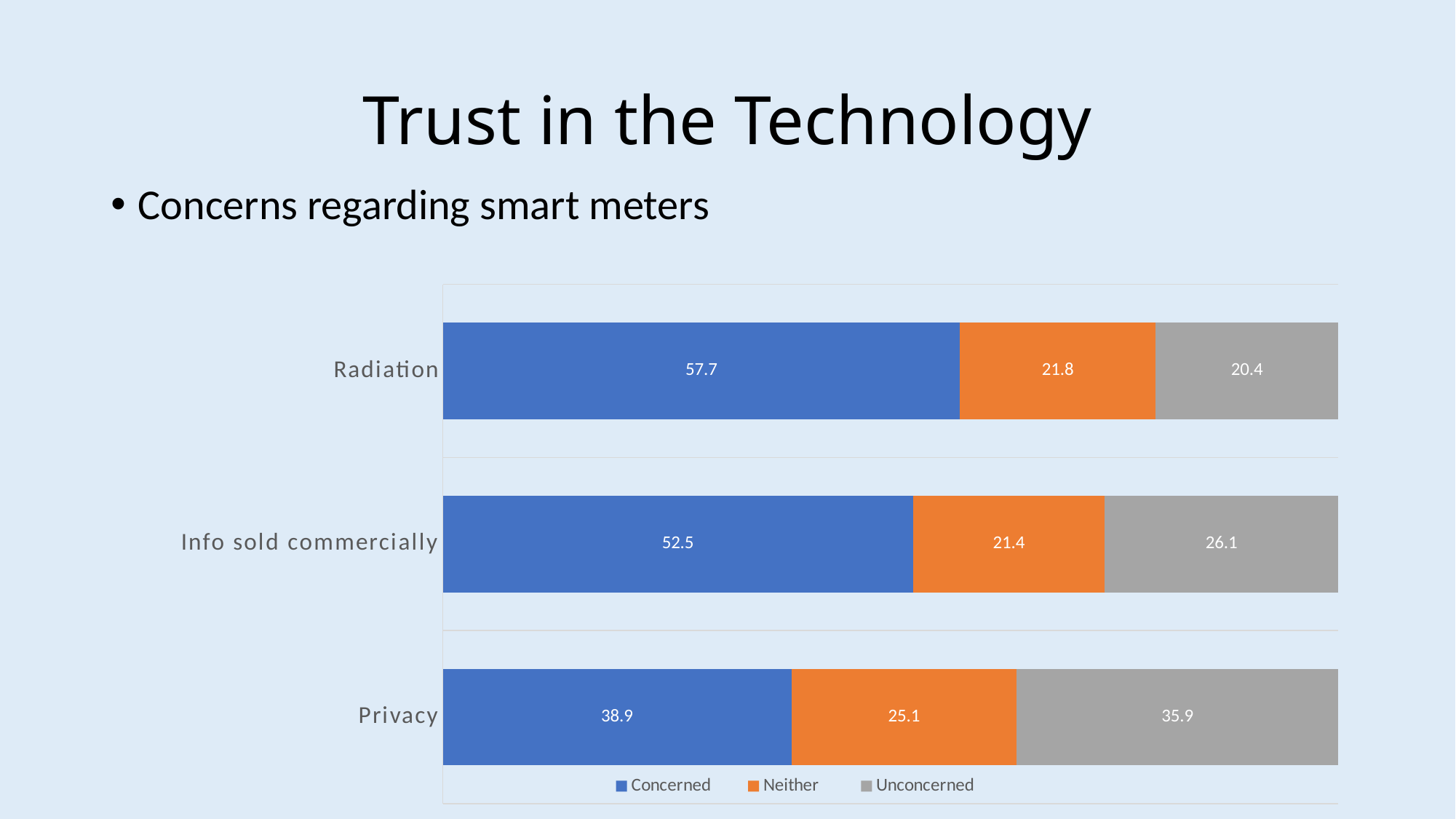
What is the Neither value for Info sold commercially? 21.4 Which category has the highest Concerned value? Radiation Which series is shown in orange in the legend? Neither What kind of chart is shown on the slide? Stacked bar chart What is the Concerned value for Radiation? 57.7 Which category has the lowest Unconcerned value? Radiation Which is larger, the Unconcerned value for Info sold commercially or the Unconcerned value for Privacy? Privacy How many series does the legend list? 3 What is the total of the stacked bar for Info sold commercially? 100.0 What is the Unconcerned value for Privacy? 35.9 What is the difference between the Concerned values for Radiation and Privacy? 18.8 How many categories are shown on the chart? 3